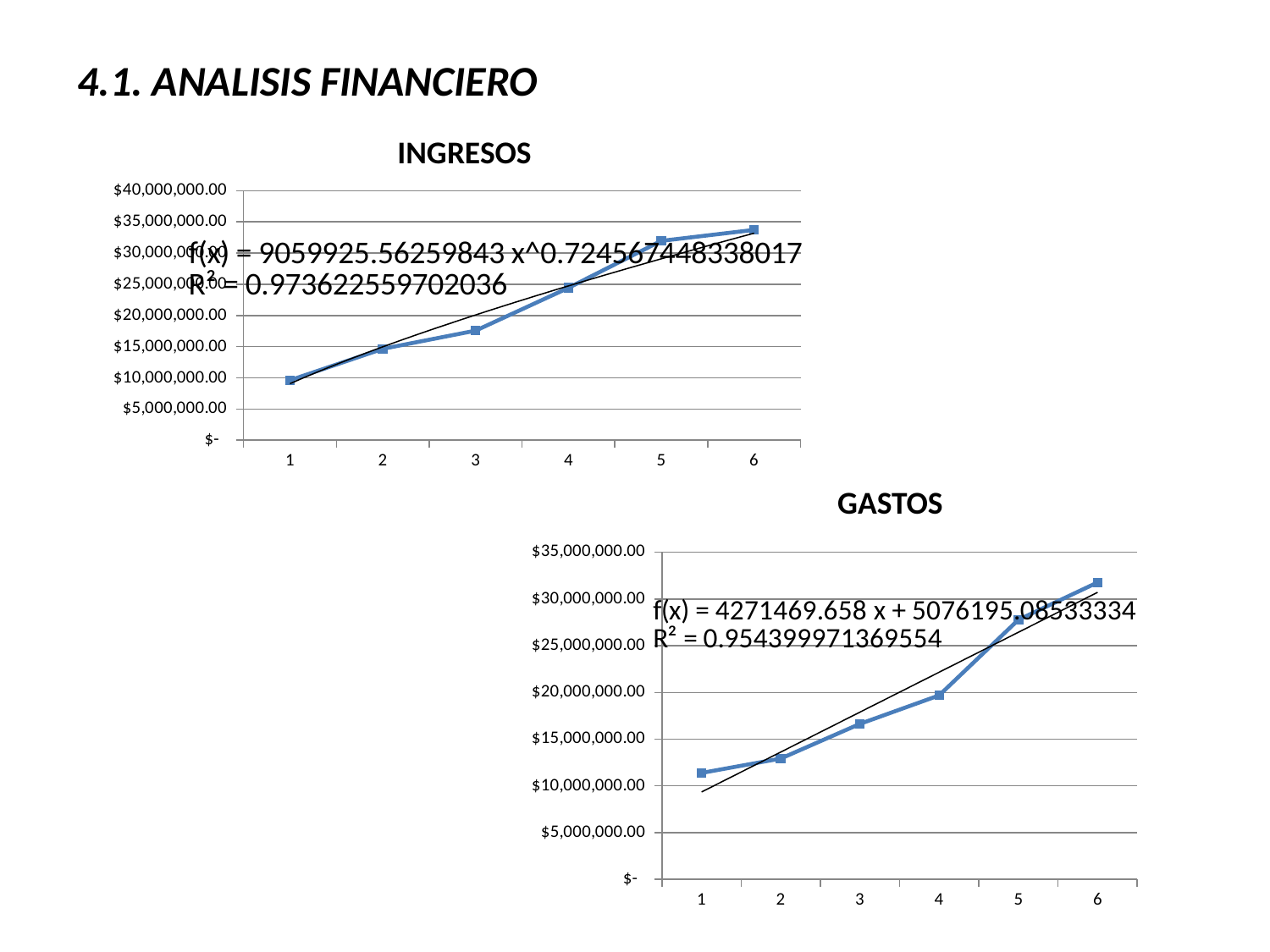
On the GASTOS chart, is the value for point 1 greater or less than $10,000,000.00? greater What R² value is shown on the GASTOS chart? 0.954399971369554 On the GASTOS chart, is the value for point 2 greater or less than $15,000,000.00? less On the INGRESOS chart, which is larger, the value for point 4 or the value for point 2? point 4 On the INGRESOS chart, do the values rise or fall from point 1 to point 6? rise On the INGRESOS chart, is the value for point 6 greater or less than $30,000,000.00? greater How many data points are plotted on the GASTOS chart? 6 On the INGRESOS chart, which point has the lowest value? 1 On the GASTOS chart, which point has the highest value? 6 What kind of chart is the INGRESOS chart? line chart